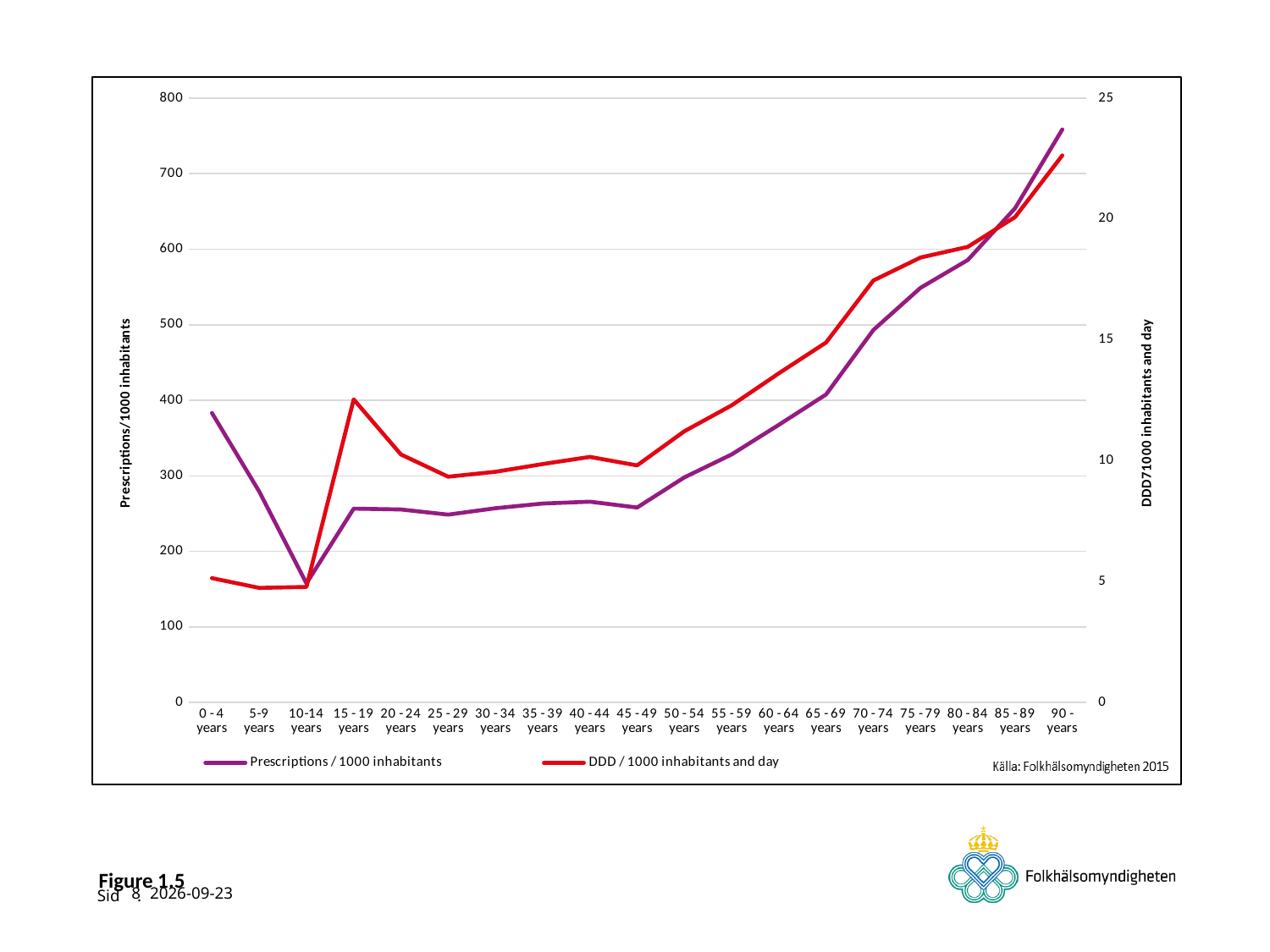
Is the value for Prescriptions / 1000 inhabitants at 0 - 4 years greater or less than 300? greater Do the values for Prescriptions / 1000 inhabitants rise or fall from 45 - 49 years to 90 - years? rise Is the value for DDD / 1000 inhabitants and day at 70 - 74 years greater or less than 15? greater Which is larger for Prescriptions / 1000 inhabitants: the value at 0 - 4 years or at 15 - 19 years? 0 - 4 years What kind of chart is shown on the slide? Line chart Which age group has the highest value for Prescriptions / 1000 inhabitants? 90 - years How many series does the legend list? 2 Which age group has the highest value for DDD / 1000 inhabitants and day? 90 - years How many age groups are shown on the x axis? 19 What colour is the line for DDD / 1000 inhabitants and day? Red Which age group has the lowest value for Prescriptions / 1000 inhabitants? 10-14 years Is the value for Prescriptions / 1000 inhabitants at 25 - 29 years greater or less than 300? less